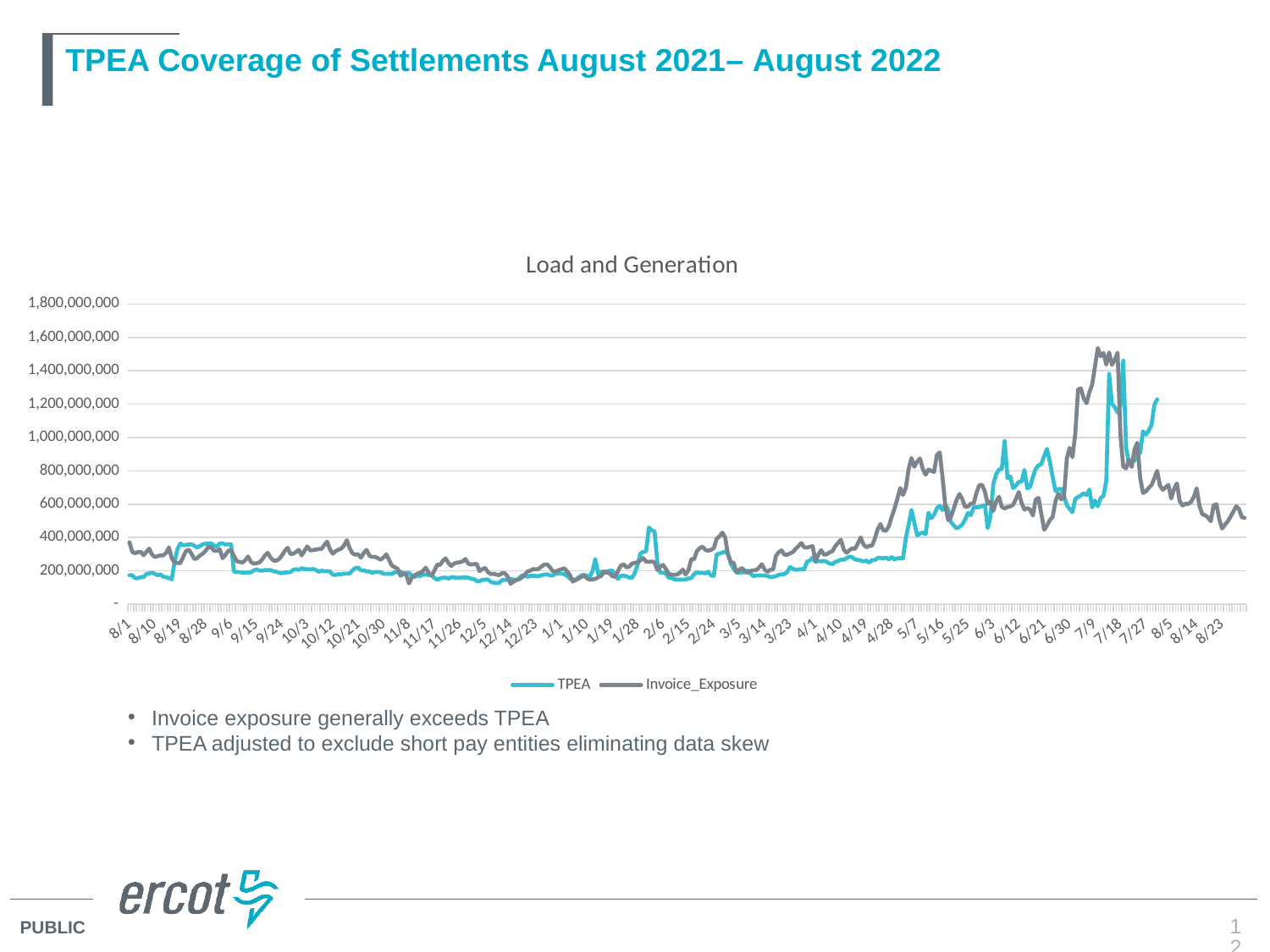
Is the peak value of Invoice_Exposure around 7/9 greater or less than 1,400,000,000? greater Does the Invoice_Exposure series generally rise or fall between 7/9 and 8/23? fall Which series is drawn in grey in the chart? Invoice_Exposure At 8/1, which series has the larger value, TPEA or Invoice_Exposure? Invoice_Exposure Is the value for Invoice_Exposure at 8/23 greater or less than 800,000,000? less Does the TPEA series generally rise or fall between 4/28 and 8/5? rise What kind of chart is shown on the slide? line chart What is the title of the chart? Load and Generation How many series does the legend of the chart list? 2 Is the value for TPEA at 8/1 greater or less than 400,000,000? less Which series reaches the highest value anywhere on the chart? Invoice_Exposure